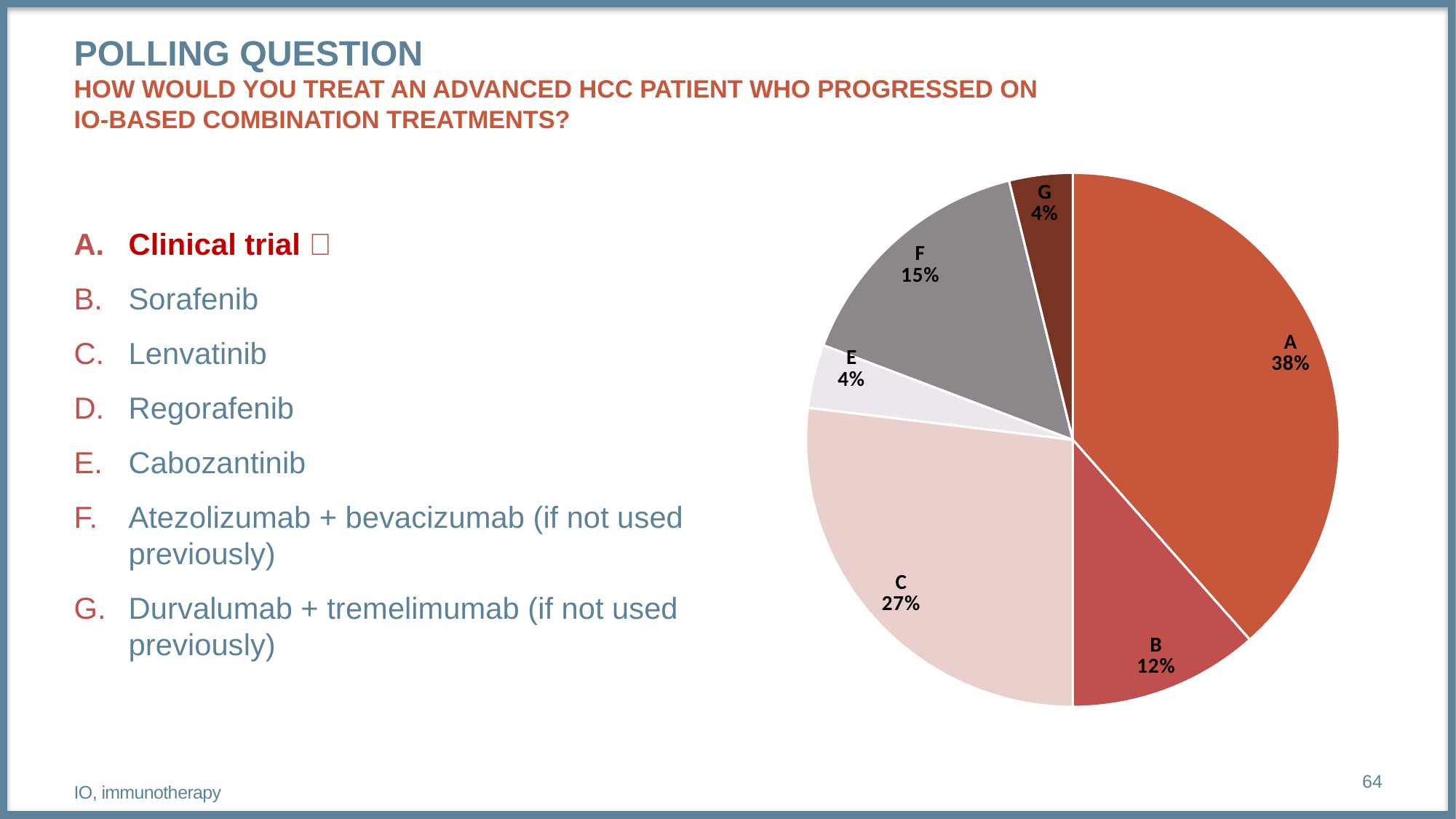
Which slice of the pie chart is the largest? A Which two slices of the pie chart have the same percentage? E and G How many slices does the pie chart have? 6 Which is larger in the pie chart, slice B or slice F? F What is the difference in percentage points between slice A and slice C? 11 What percentage of the pie chart is slice A? 38% What kind of chart is shown on the slide? Pie chart Which polling option does slice A of the pie chart correspond to? Clinical trial What percentage of the pie chart is slice B? 12% What percentage of the pie chart is slice F? 15% What share of the pie does slice G represent? 4% What percentage of the pie chart is slice C? 27%